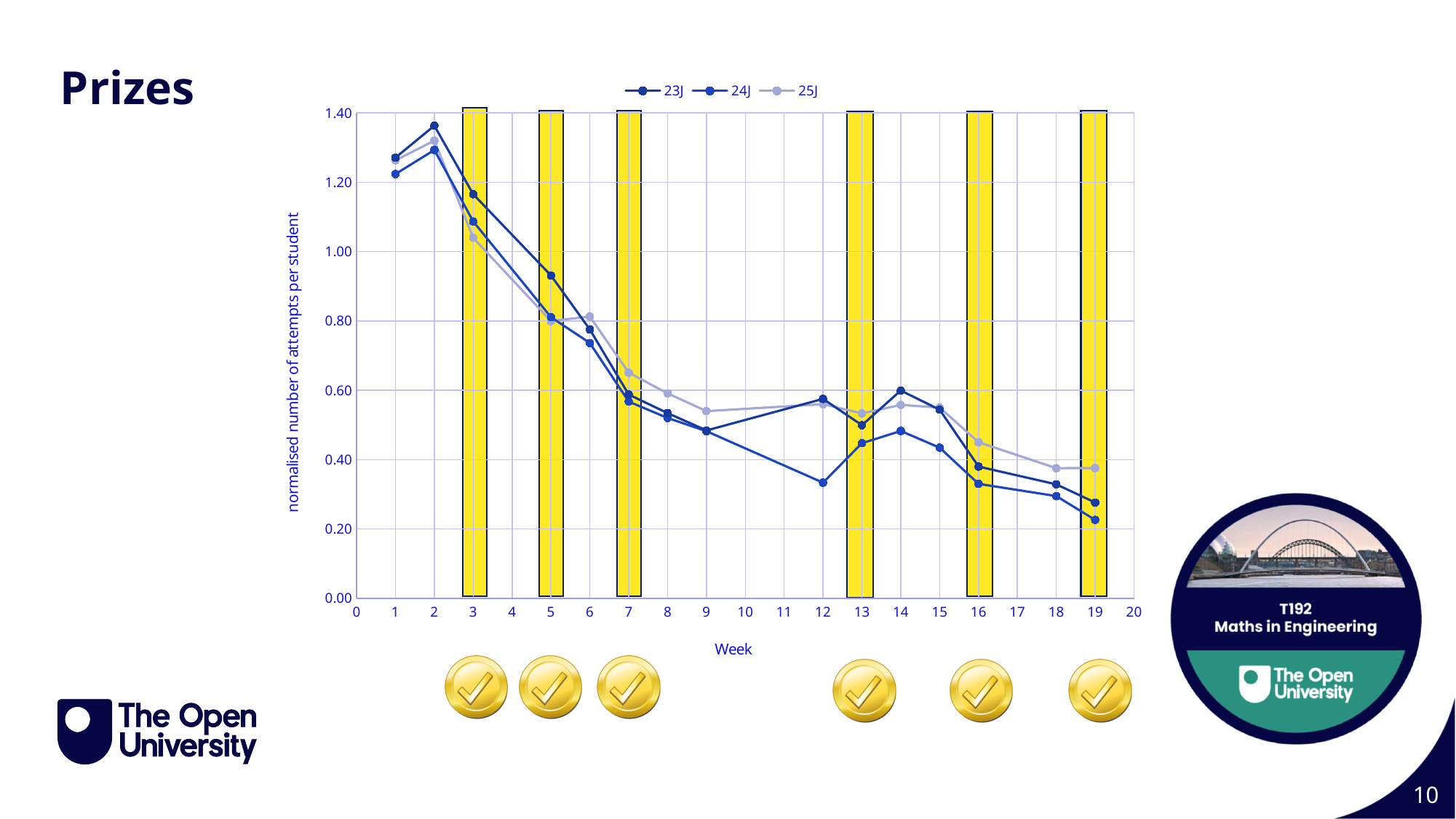
Is the value for 23J at week 2 greater or less than 1.20? greater At week 19, which series has the larger value, 24J or 25J? 25J How many series does the legend list? 3 At which week does the 24J series reach its lowest value? 19 Overall, do the values for 23J rise or fall from week 1 to week 19? fall At which week does the 23J series reach its highest value? 2 Is the value for 24J at week 12 greater or less than 0.40? less What are the series names listed in the legend? 23J, 24J, 25J At week 12, which series has the larger value, 23J or 24J? 23J What kind of chart is shown on the slide? line chart Is the value for 23J at week 5 greater or less than 0.80? greater What is the title of the vertical axis? normalised number of attempts per student